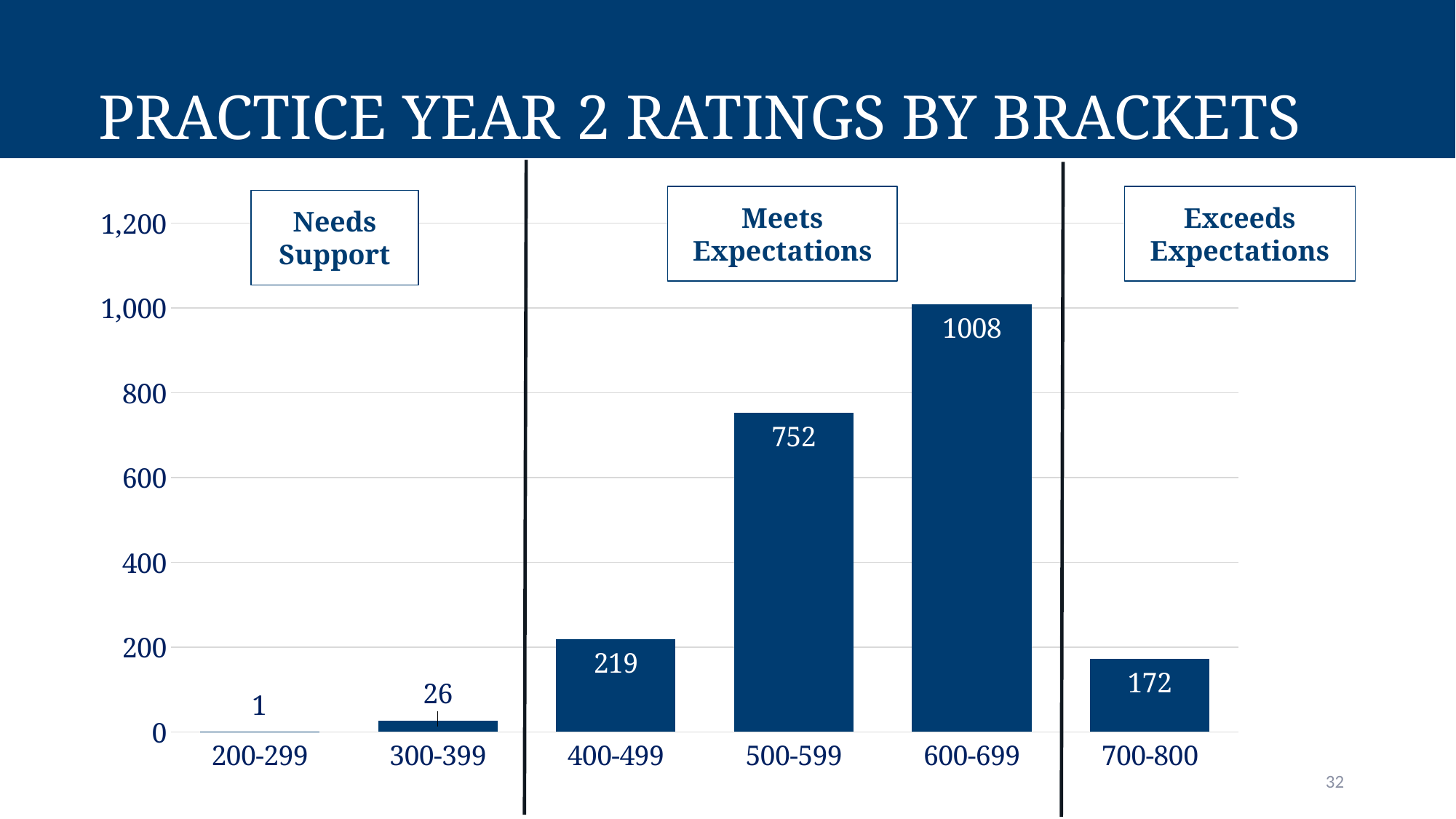
Which is larger, the value for 300-399 or the value for 700-800? 700-800 How many brackets are shown on the x axis? 6 What is the value for the 700-800 bracket? 172 Is the value for 500-599 greater or less than 800? less What kind of chart is shown on the slide? bar chart Which label is shown above the 700-800 bracket? Exceeds Expectations What is the value for the 400-499 bracket? 219 Which bracket has the highest value? 600-699 What is the difference between the values for 600-699 and 500-599? 256 What is the value for the 600-699 bracket? 1008 What is the difference between the values for 400-499 and 700-800? 47 Which bracket has the lowest value? 200-299